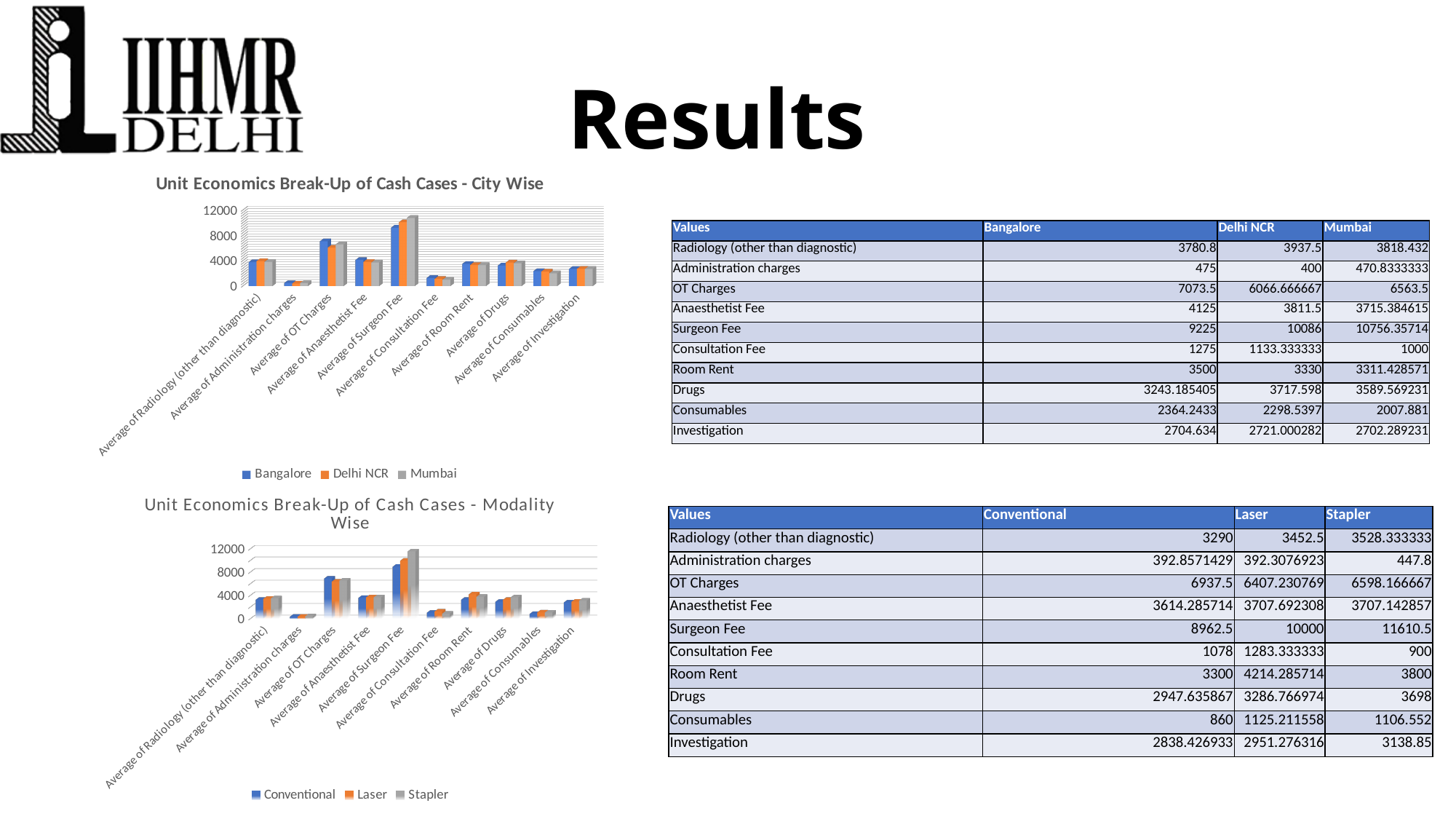
What kind of chart is 'Unit Economics Break-Up of Cash Cases - City Wise'? Bar chart In the 'Unit Economics Break-Up of Cash Cases - City Wise' chart, is the Bangalore value for Average of Surgeon Fee greater or less than 8000? greater In the 'Unit Economics Break-Up of Cash Cases - City Wise' chart, what is the Mumbai value for Surgeon Fee as printed in the table? 10756.35714 In the 'Unit Economics Break-Up of Cash Cases - Modality Wise' chart, which is larger for Average of Surgeon Fee: Conventional or Stapler? Stapler In the 'Unit Economics Break-Up of Cash Cases - Modality Wise' chart, what is the difference between the Stapler and Conventional values for Surgeon Fee, using the values printed in the table? 2648 In the 'Unit Economics Break-Up of Cash Cases - City Wise' chart, which category has the tallest bars? Average of Surgeon Fee Which series does the legend of the 'Unit Economics Break-Up of Cash Cases - Modality Wise' chart list? Conventional, Laser, Stapler How many series does the legend of the 'Unit Economics Break-Up of Cash Cases - City Wise' chart list? 3 In the 'Unit Economics Break-Up of Cash Cases - Modality Wise' chart, is the Conventional value for Average of OT Charges greater or less than 4000? greater In the 'Unit Economics Break-Up of Cash Cases - Modality Wise' chart, which category has the tallest bars? Average of Surgeon Fee In the 'Unit Economics Break-Up of Cash Cases - City Wise' chart, which category has the shortest bars? Average of Administration charges How many categories are plotted along the x axis of the 'Unit Economics Break-Up of Cash Cases - City Wise' chart? 10